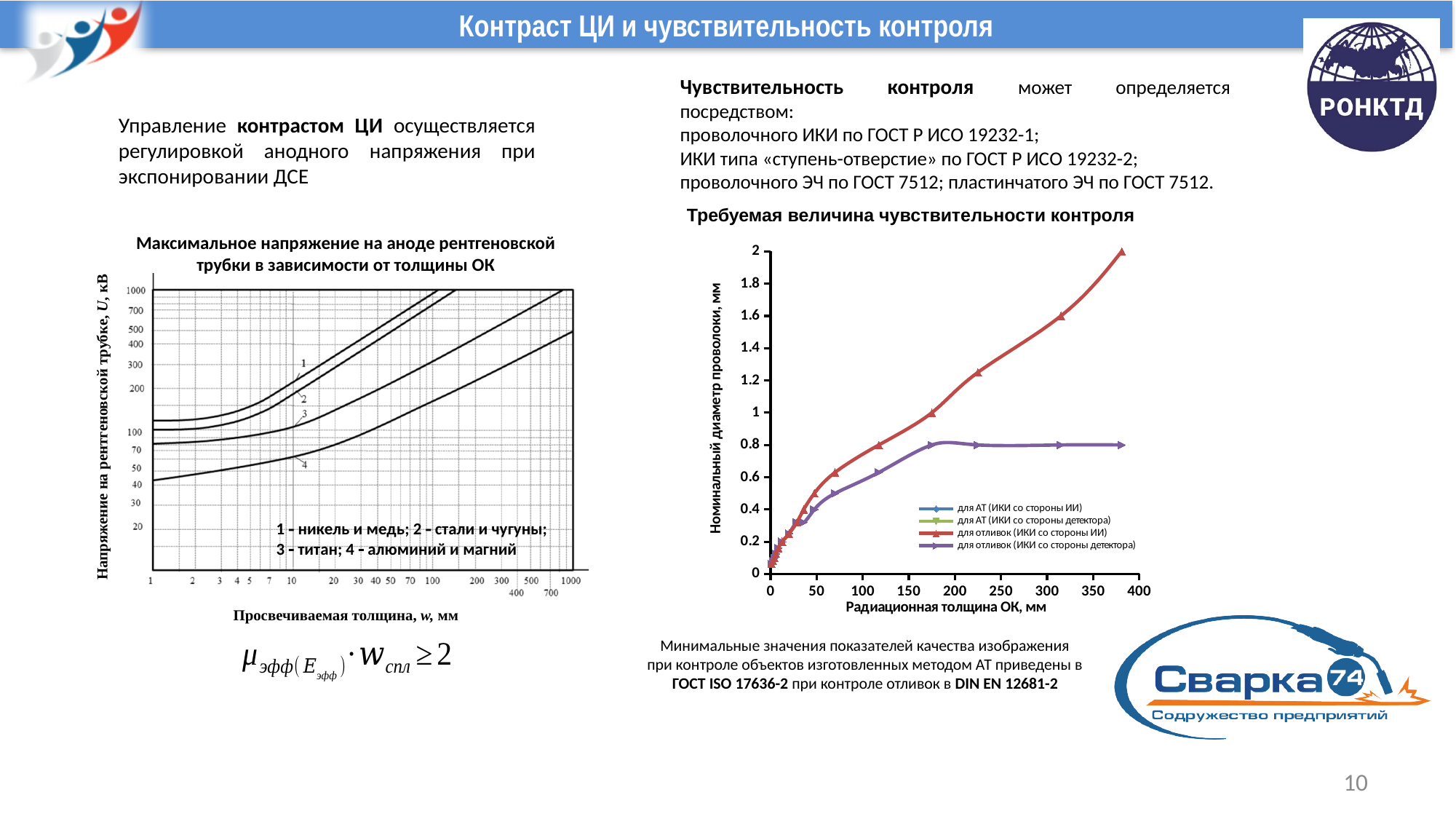
In the chart "Требуемая величина чувствительности контроля", is the value of the series "для отливок (ИКИ со стороны ИИ)" at a radiation thickness of 300 mm greater or less than 1.4? greater How many series does the legend of the chart "Требуемая величина чувствительности контроля" list? 4 In the chart "Требуемая величина чувствительности контроля", what is the label of the y axis? Номинальный диаметр проволоки, мм In the chart "Максимальное напряжение на аноде рентгеновской трубки в зависимости от толщины ОК", which curve has the lowest voltage values? 4 – алюминий и магний In the chart "Требуемая величина чувствительности контроля", which series has the higher value at a radiation thickness of 350 mm: "для отливок (ИКИ со стороны ИИ)" or "для отливок (ИКИ со стороны детектора)"? для отливок (ИКИ со стороны ИИ) In the chart "Требуемая величина чувствительности контроля", does the series "для отливок (ИКИ со стороны ИИ)" rise or fall as radiation thickness increases? rise In the chart "Требуемая величина чувствительности контроля", what is the label of the x axis? Радиационная толщина ОК, мм In the chart "Требуемая величина чувствительности контроля", is the value of the series "для отливок (ИКИ со стороны детектора)" at a radiation thickness of 300 mm greater or less than 1? less How many curves are plotted in the chart "Максимальное напряжение на аноде рентгеновской трубки в зависимости от толщины ОК"? 4 What kind of chart is the chart titled "Требуемая величина чувствительности контроля"? line chart What kind of chart is the chart titled "Максимальное напряжение на аноде рентгеновской трубки в зависимости от толщины ОК"? line chart In the chart "Требуемая величина чувствительности контроля", is the value of the series "для отливок (ИКИ со стороны ИИ)" at a radiation thickness of 100 mm greater or less than 0.6? greater